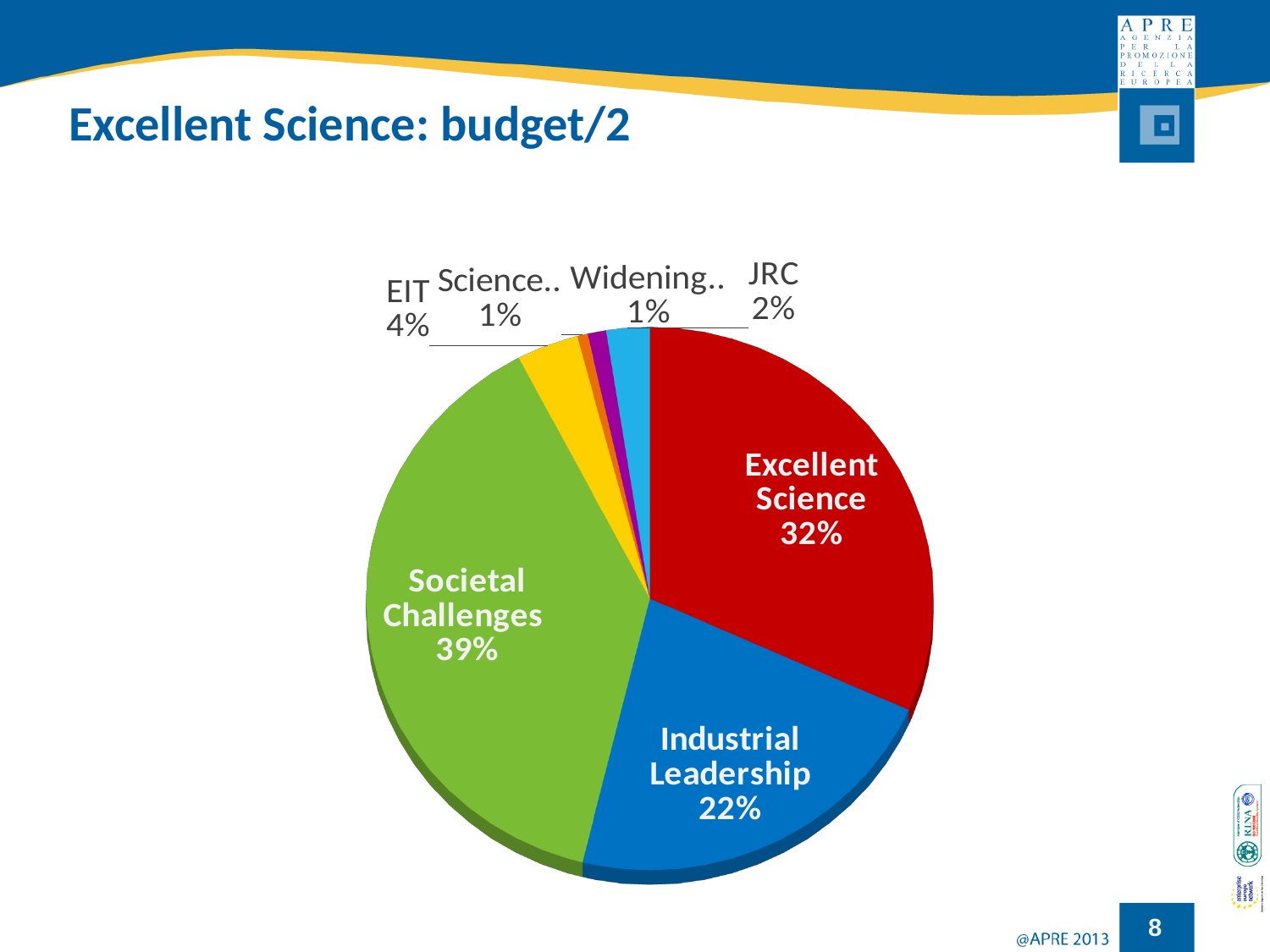
What is the value shown for JRC? 2% What share of the pie does Industrial Leadership have? 22% Which is larger, Excellent Science or Industrial Leadership? Excellent Science What is the difference between the Societal Challenges share and the Excellent Science share? 7% Which slice of the pie is the largest? Societal Challenges What share of the pie does Societal Challenges have? 39% What is the value shown for EIT? 4% What share of the pie does Excellent Science have? 32% How many slices does the pie chart have? 7 What is the difference between the Excellent Science share and the Industrial Leadership share? 10% What type of chart is shown on the slide? pie chart What is the title of the slide containing the pie chart? Excellent Science: budget/2